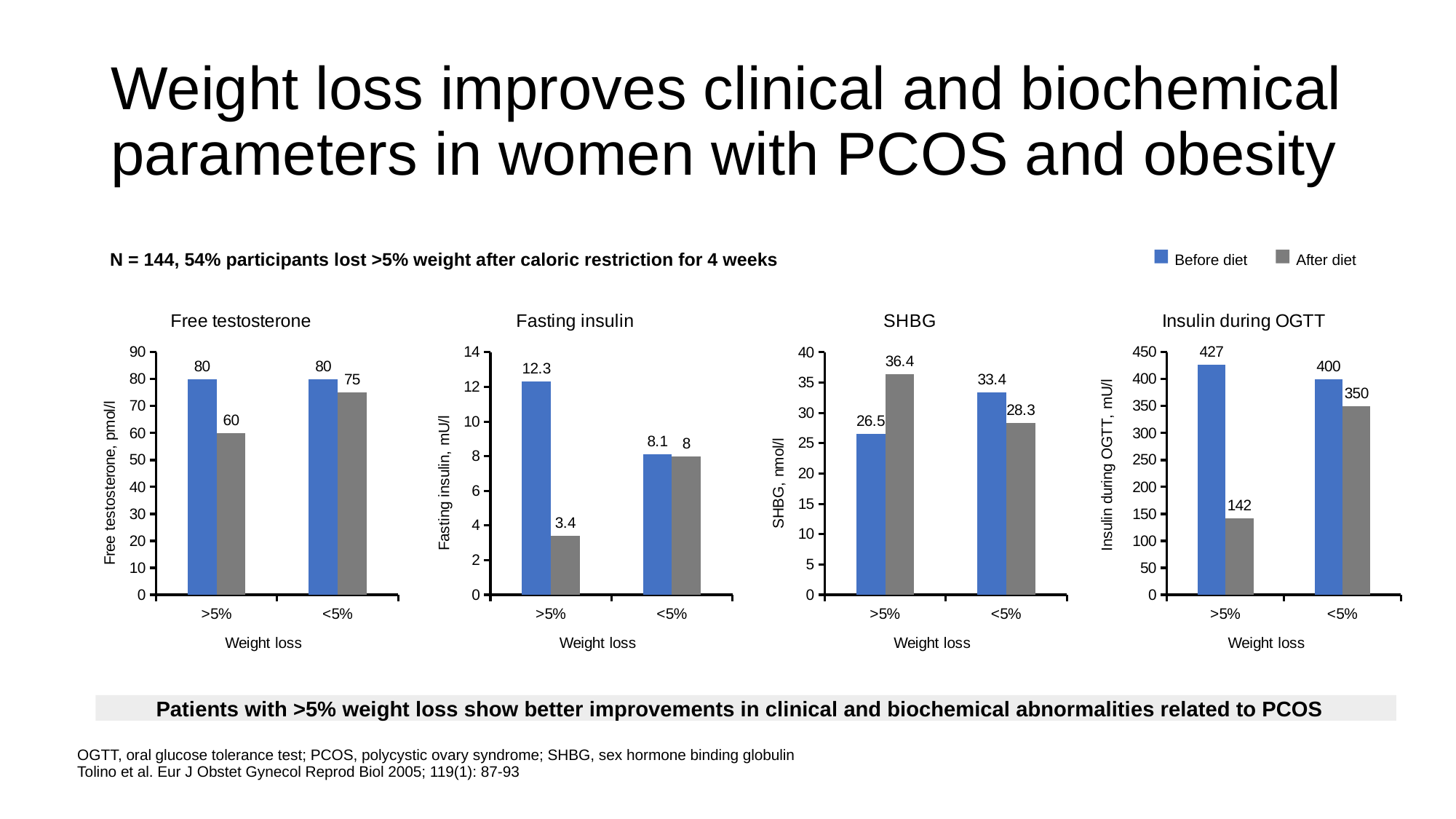
In the SHBG chart, which bar is the highest? After diet, >5% What colour represents Before diet in the legend? blue In the Insulin during OGTT chart, which bar is the lowest? After diet, >5% In the Insulin during OGTT chart, what is the difference between Before diet and After diet in the <5% weight loss group? 50 In the Free testosterone chart, what is the value for After diet in the >5% weight loss group? 60 In the SHBG chart, what is the value for After diet in the <5% weight loss group? 28.3 How many series does the legend list? 2 What kind of chart is the Free testosterone chart? bar chart In the SHBG chart, is the Before diet value for the >5% group larger or smaller than the After diet value for the same group? smaller In the Fasting insulin chart, what is the difference between Before diet and After diet in the >5% weight loss group? 8.9 In the Insulin during OGTT chart, what is the value for After diet in the >5% weight loss group? 142 In the Fasting insulin chart, what is the value for Before diet in the >5% weight loss group? 12.3